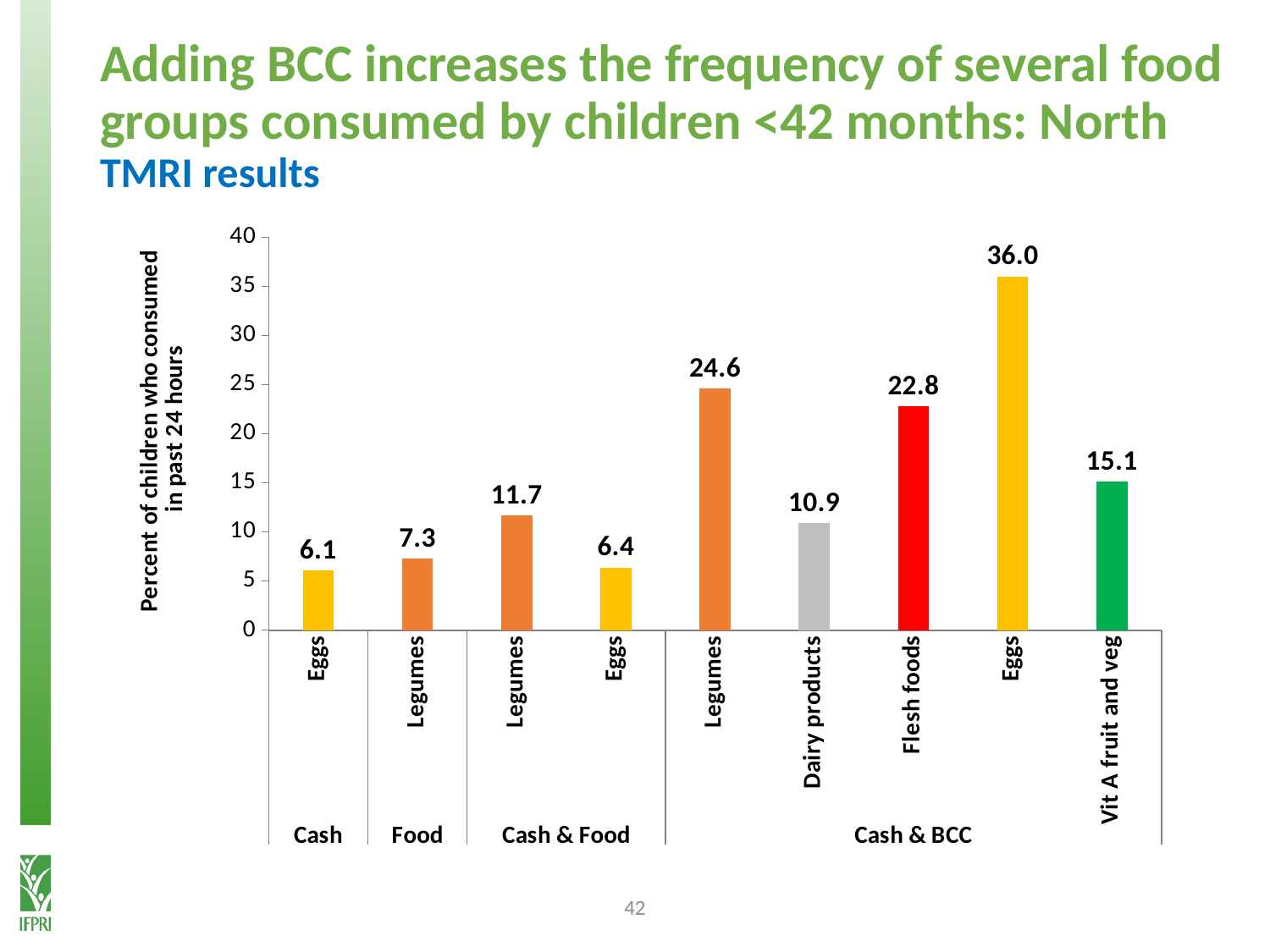
Which bar has the highest value on the chart? Eggs (Cash & BCC) What is the value for Eggs in the Cash group? 6.1 What is the value for Eggs in the Cash & BCC group? 36.0 Which is larger: Flesh foods in the Cash & BCC group or Vit A fruit and veg in the Cash & BCC group? Flesh foods What is the difference between Legumes in the Cash & BCC group and Legumes in the Cash & Food group? 12.9 Is the value for Legumes in the Cash & BCC group greater or less than 20? greater Which bar has the lowest value on the chart? Eggs (Cash) What is the label of the vertical axis? Percent of children who consumed in past 24 hours How many bars are plotted on the chart? 9 What kind of chart is shown on the slide? bar chart What is the value for Legumes in the Cash & Food group? 11.7 What is the value for Dairy products in the Cash & BCC group? 10.9